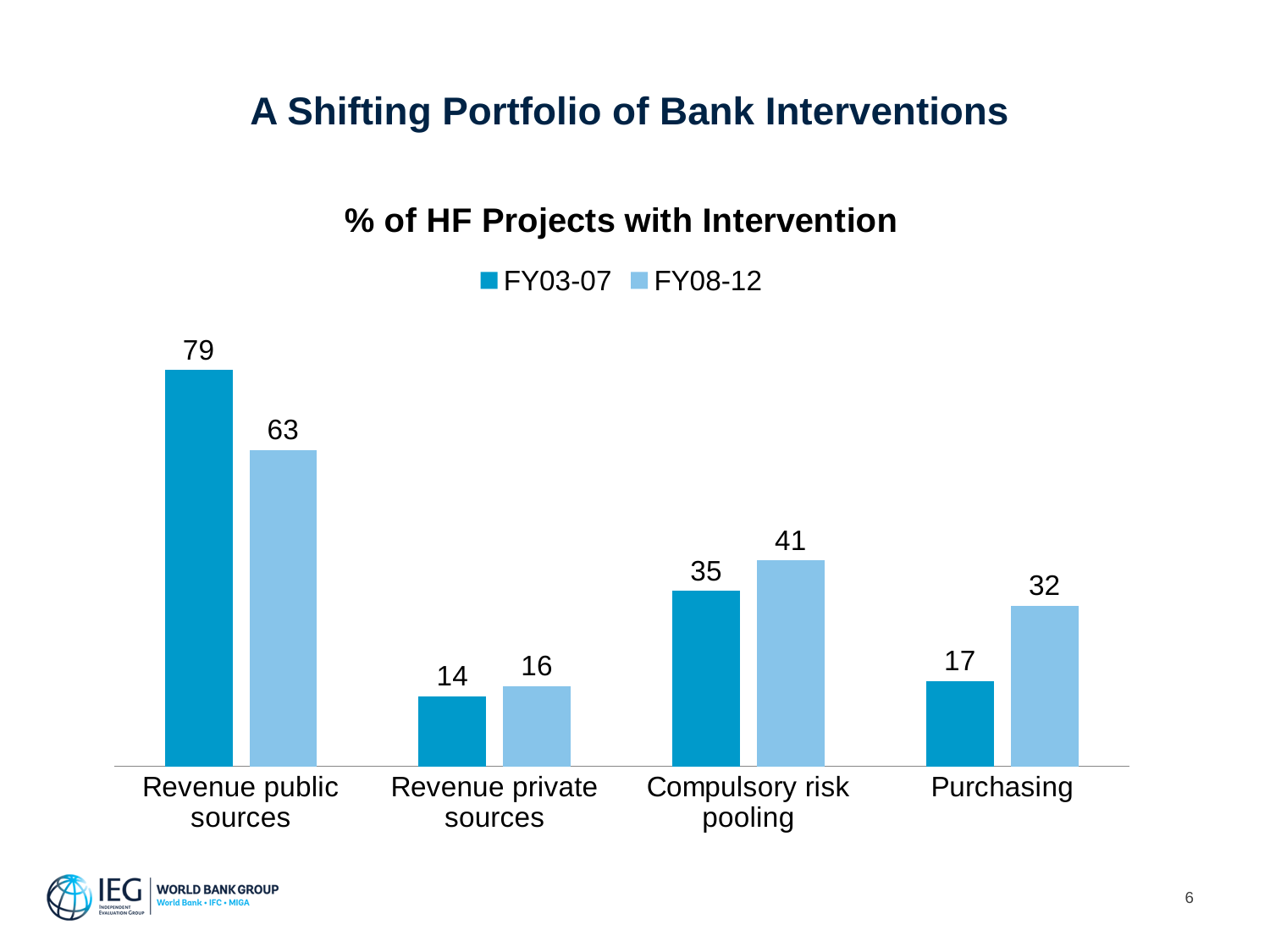
What kind of chart is shown on the slide? Bar chart What is the difference between the FY08-12 and FY03-07 values for Purchasing? 15 Which category has the highest FY03-07 value? Revenue public sources How many categories are shown on the x axis? 4 What is the FY08-12 value for Purchasing? 32 How many series does the legend list? 2 Which is larger for Compulsory risk pooling, the FY03-07 value or the FY08-12 value? FY08-12 What is the difference between the FY03-07 and FY08-12 values for Revenue public sources? 16 What is the title of the chart? % of HF Projects with Intervention What is the FY08-12 value for Compulsory risk pooling? 41 Which category has the lowest FY08-12 value? Revenue private sources What is the FY03-07 value for Revenue public sources? 79